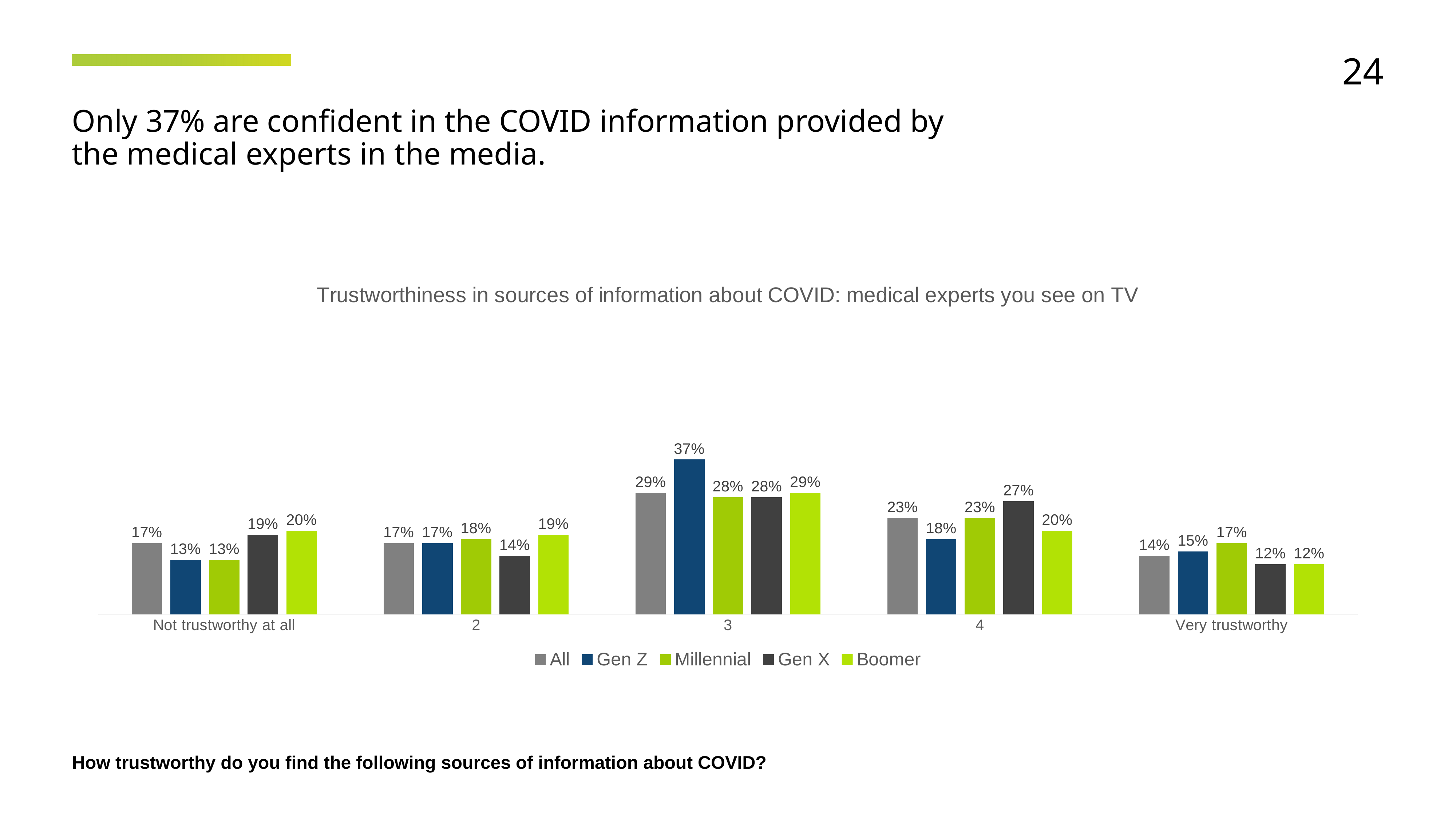
What is the value for Gen Z in the "3" category? 37% What is the title of the chart? Trustworthiness in sources of information about COVID: medical experts you see on TV What is the value for Gen X in the "Very trustworthy" category? 12% Which is larger in the "Very trustworthy" category: Millennial or Boomer? Millennial How many categories are shown on the x axis? 5 Which series has the highest value in the "3" category? Gen Z How many series does the legend list? 5 What kind of chart is shown on the slide? Bar chart Which series has the lowest value in the "2" category? Gen X What is the value for All in the "4" category? 23% What is the value for Boomer in the "Not trustworthy at all" category? 20% What is the difference between Gen X and Gen Z in the "4" category? 9%